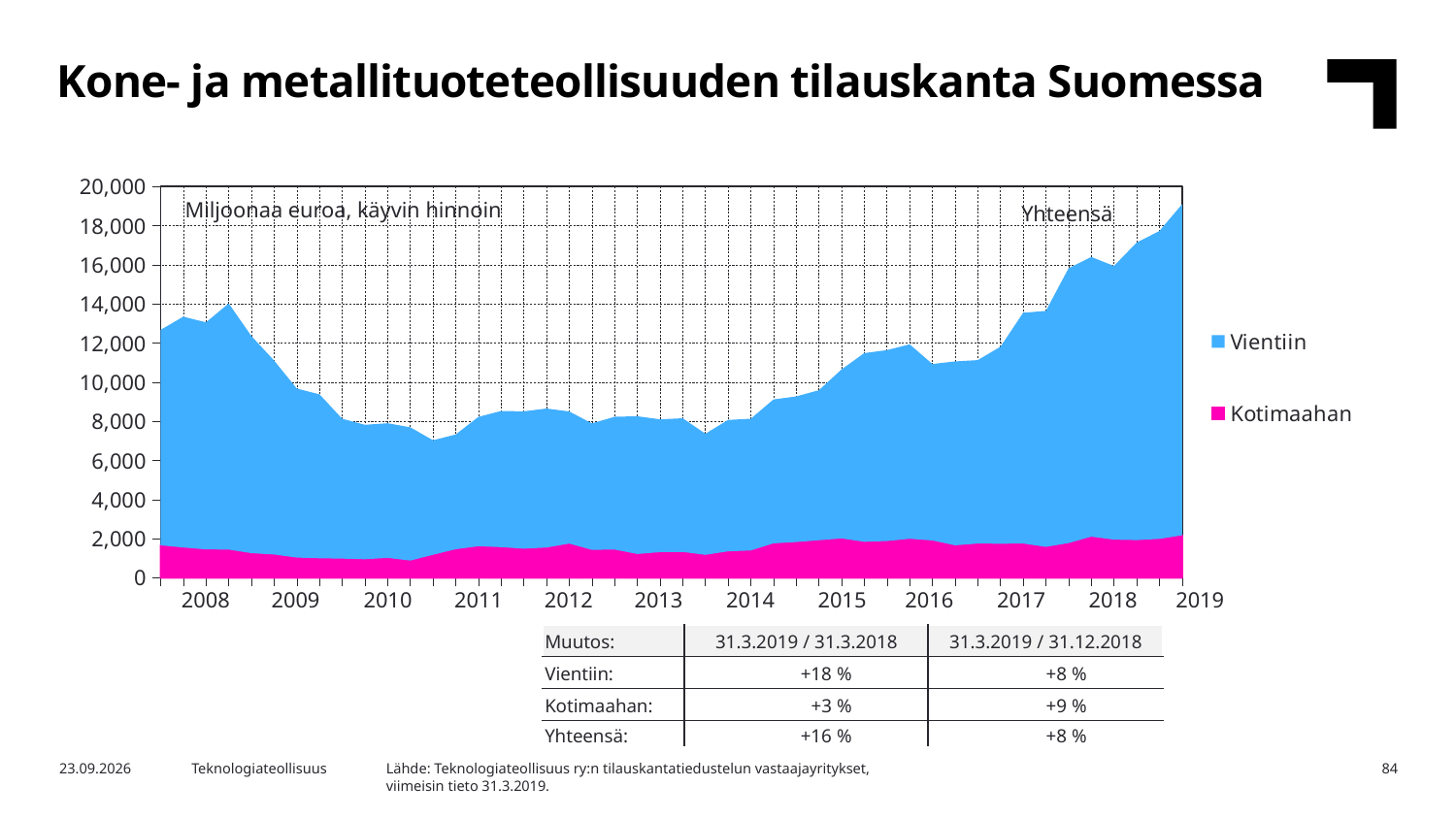
What kind of chart is shown on the slide? Stacked area chart Is the Kotimaahan value in 2010 greater or less than 2,000? less How many year labels are shown on the x axis? 12 How many series does the legend list? 2 What is the title of the chart on the slide? Kone- ja metallituoteteollisuuden tilauskanta Suomessa Does the total order book rise or fall between 2016 and 2019? Rise What are the two series named in the legend? Vientiin and Kotimaahan Is the total (Yhteensä) value in 2012 greater or less than 10,000? less Is the total (Yhteensä) value at the end of the series in 2019 greater or less than 18,000? greater Does the total order book rise or fall between 2008 and 2010? Fall Which series accounts for the larger part of the total order book throughout the period, Vientiin or Kotimaahan? Vientiin